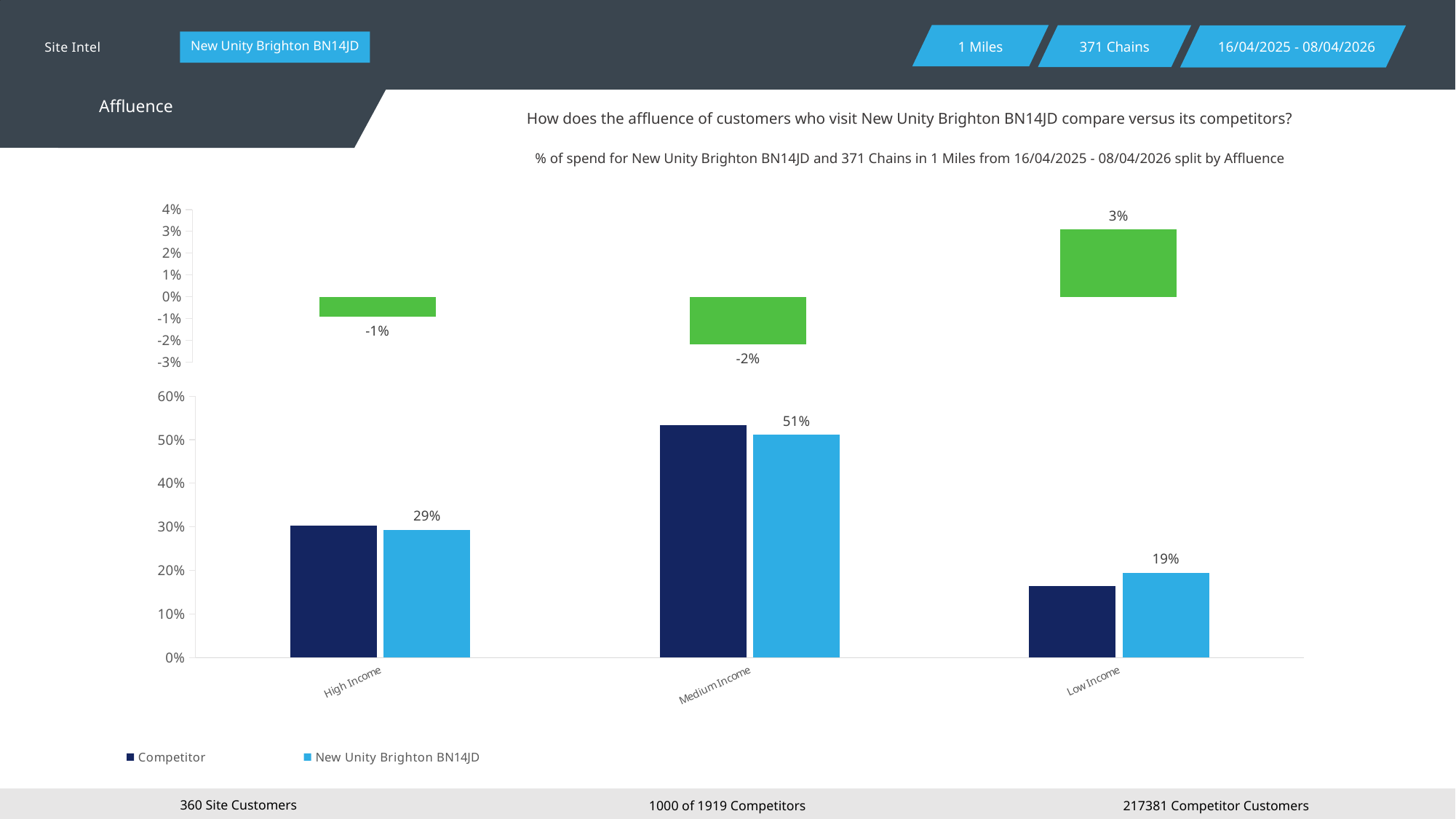
In the bottom chart, is the Competitor value for Low Income greater or less than 20%? less How many series does the legend of the bottom chart list? 2 What kind of chart is the bottom chart? Bar chart In the bottom chart, what is the value for New Unity Brighton BN14JD in the Low Income category? 19% In the bottom chart, what is the difference between the New Unity Brighton BN14JD values for Medium Income and High Income? 22% In the bottom chart, what is the value for New Unity Brighton BN14JD in the Medium Income category? 51% In the top chart, what is the value shown for the Low Income category? 3% In the bottom chart, which category has the highest value for New Unity Brighton BN14JD? Medium Income In the top chart, what is the value shown for the Medium Income category? -2% In the bottom chart, which category has the lowest value for New Unity Brighton BN14JD? Low Income In the bottom chart, what is the value for New Unity Brighton BN14JD in the High Income category? 29% In the bottom chart, is the Competitor value for Medium Income greater or less than 50%? greater